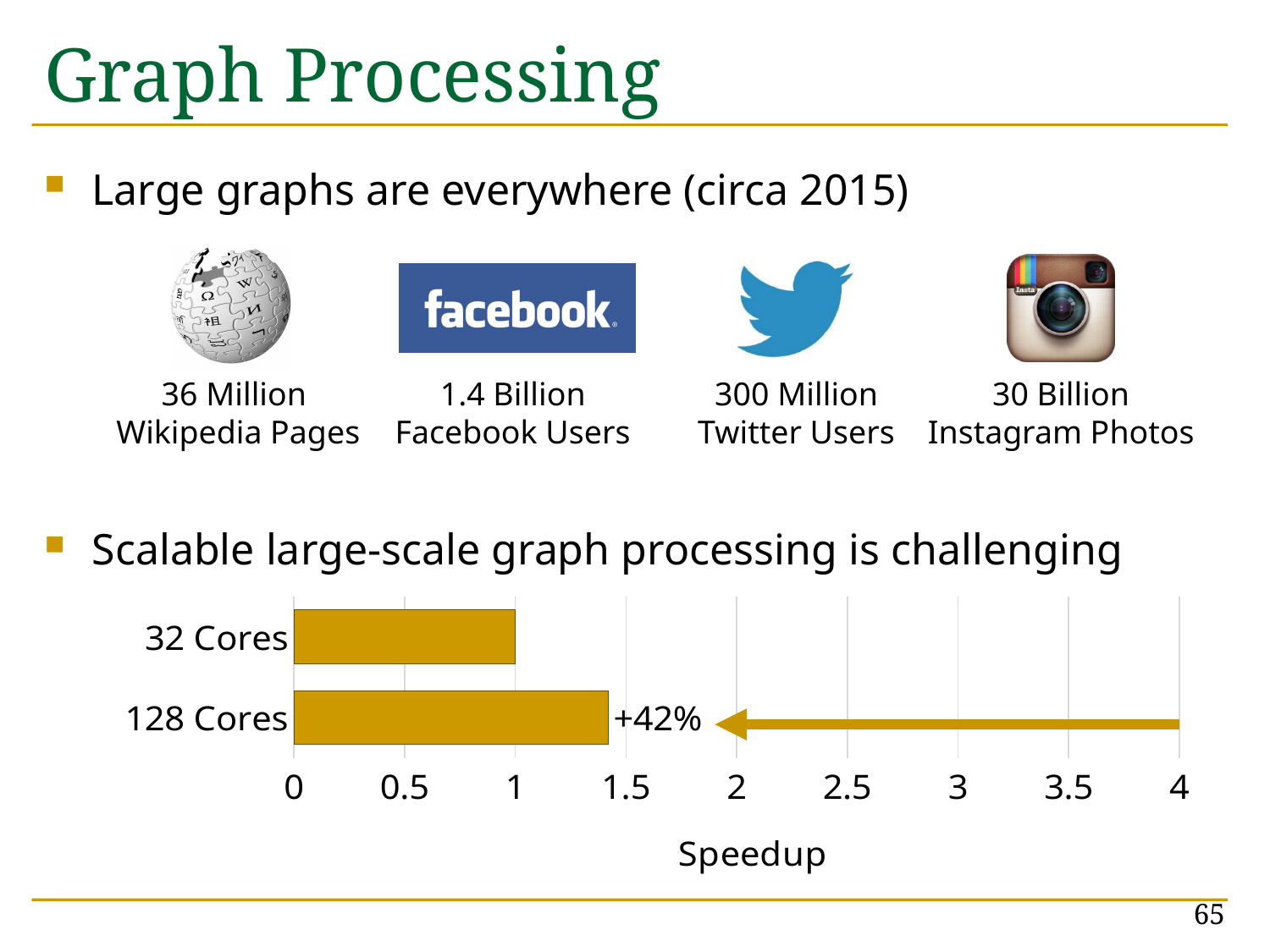
What kind of chart is shown at the bottom of the slide? bar chart What is the label of the x axis of the bar chart? Speedup Is the speedup for 128 Cores greater or less than 1.5? less Is the speedup for 128 Cores greater or less than 2? less How many categories are plotted in the Speedup bar chart? 2 What is the speedup value for 32 Cores? 1 Which category has the lowest speedup? 32 Cores Is the speedup for 128 Cores greater or less than 1? greater Which has a larger speedup, 32 Cores or 128 Cores? 128 Cores Which category has the highest speedup? 128 Cores What annotation is printed next to the 128 Cores bar? +42%